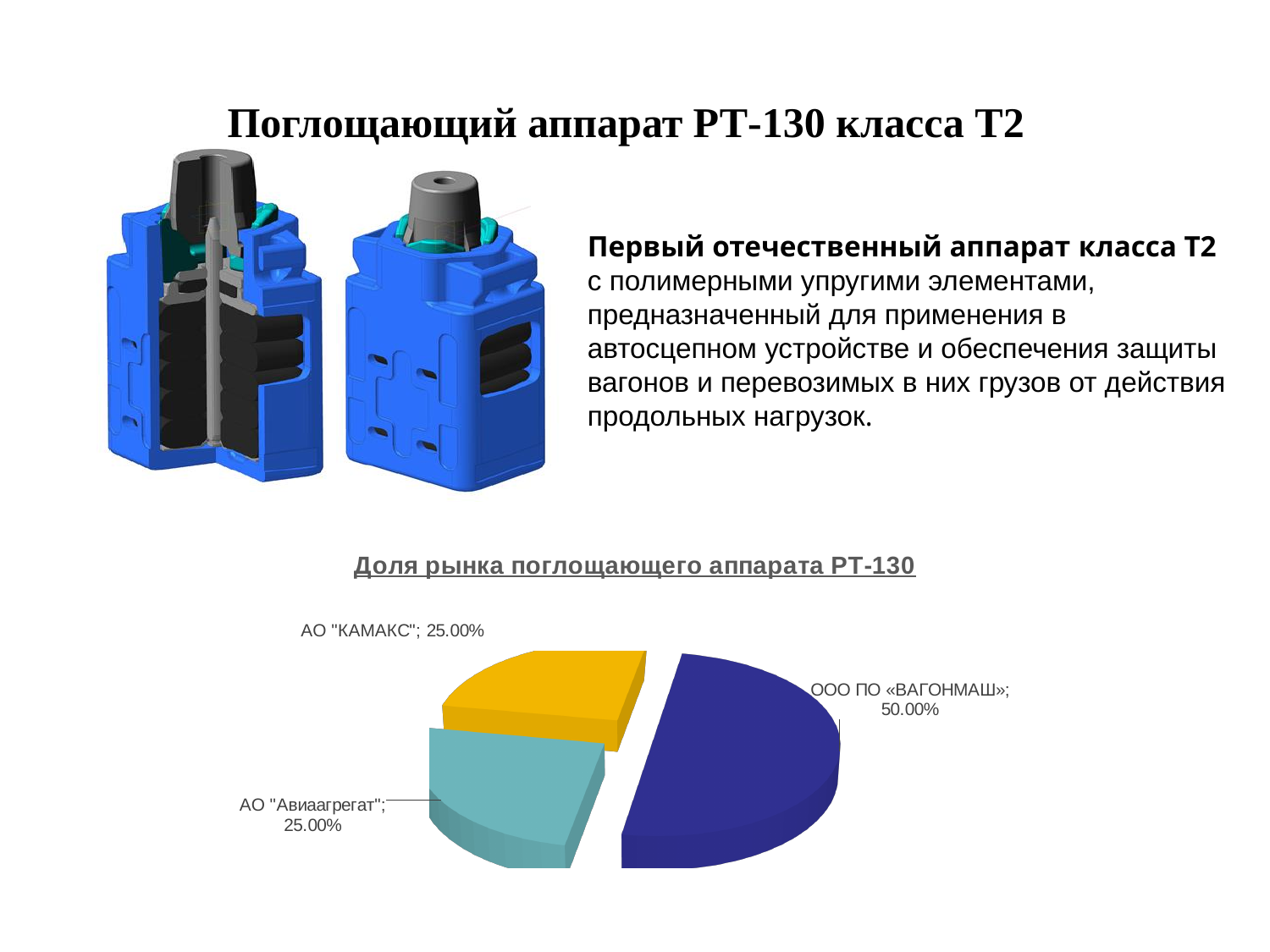
Which company has the largest share in the pie chart? ООО ПО «ВАГОНМАШ» What is the market share of АО "КАМАКС" in the pie chart? 25.00% How many slices does the pie chart have? 3 Which is larger in the pie chart: the share of ООО ПО «ВАГОНМАШ» or the share of АО "Авиаагрегат"? ООО ПО «ВАГОНМАШ» What is the market share of АО "Авиаагрегат" in the pie chart? 25.00% What is the market share of ООО ПО «ВАГОНМАШ» in the pie chart? 50.00% What is the title of the pie chart on the slide? Доля рынка поглощающего аппарата РТ-130 What colour is the slice for ООО ПО «ВАГОНМАШ» in the pie chart? dark blue What is the combined share of АО "КАМАКС" and АО "Авиаагрегат" in the pie chart? 50.00% What is the difference between the share of ООО ПО «ВАГОНМАШ» and the share of АО "КАМАКС"? 25.00% What kind of chart is shown under the title "Доля рынка поглощающего аппарата РТ-130"? pie chart